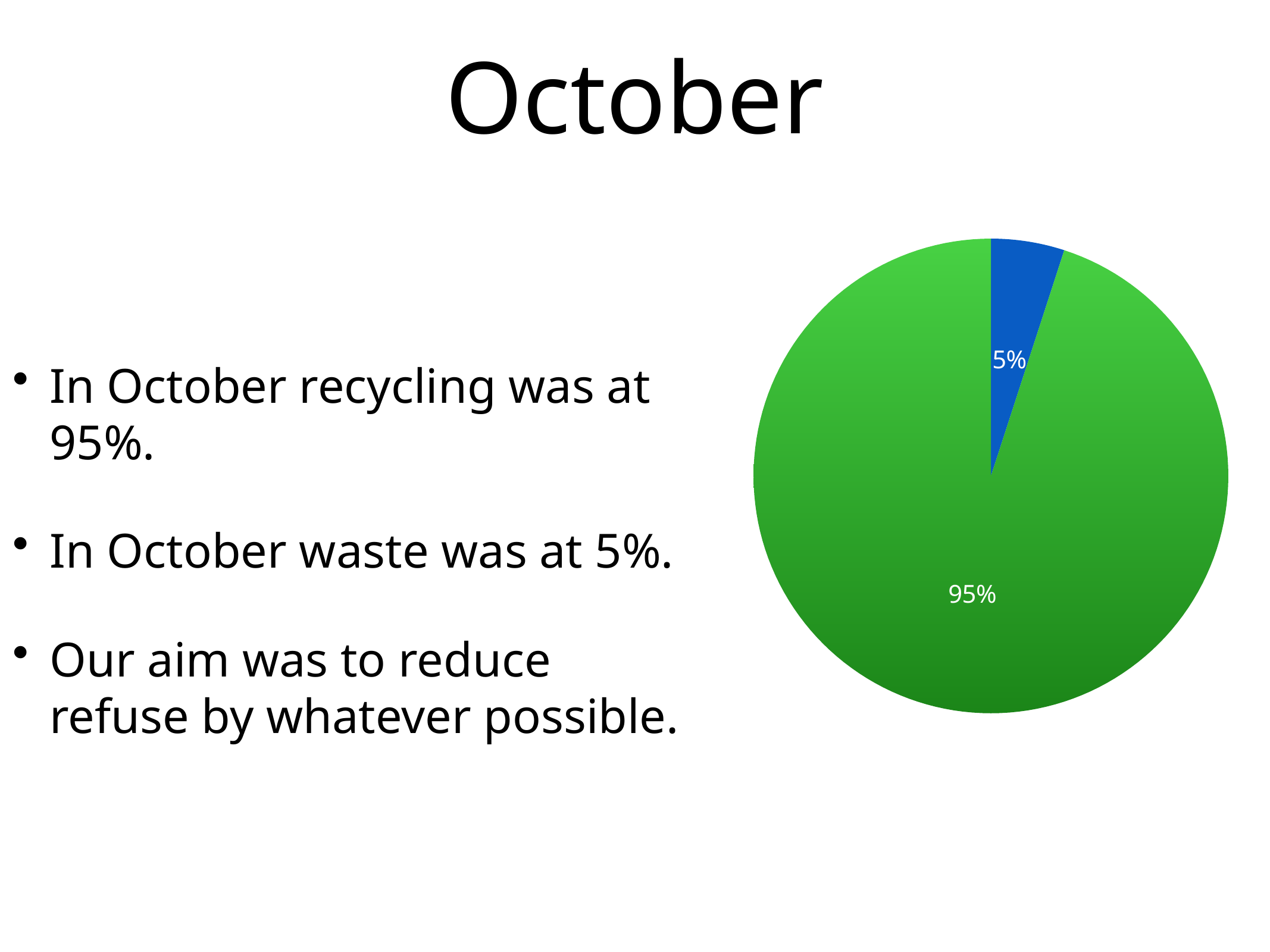
What colour is the slice representing 5% in the pie chart? blue What is the smallest slice value in the pie chart? 5% What is the largest slice value in the pie chart? 95% Which slice is larger in the pie chart, the green one or the blue one? the green one What percentage is shown on the large green slice of the pie chart? 95% What is the title of the slide containing the pie chart? October What kind of chart is shown on the slide? pie chart According to the slide, what share of the pie chart represents recycling in October? 95% How many slices does the pie chart have? 2 What percentage is shown on the small blue slice of the pie chart? 5% What is the difference between the two slice values in the pie chart? 90% According to the slide, what share of the pie chart represents waste in October? 5%